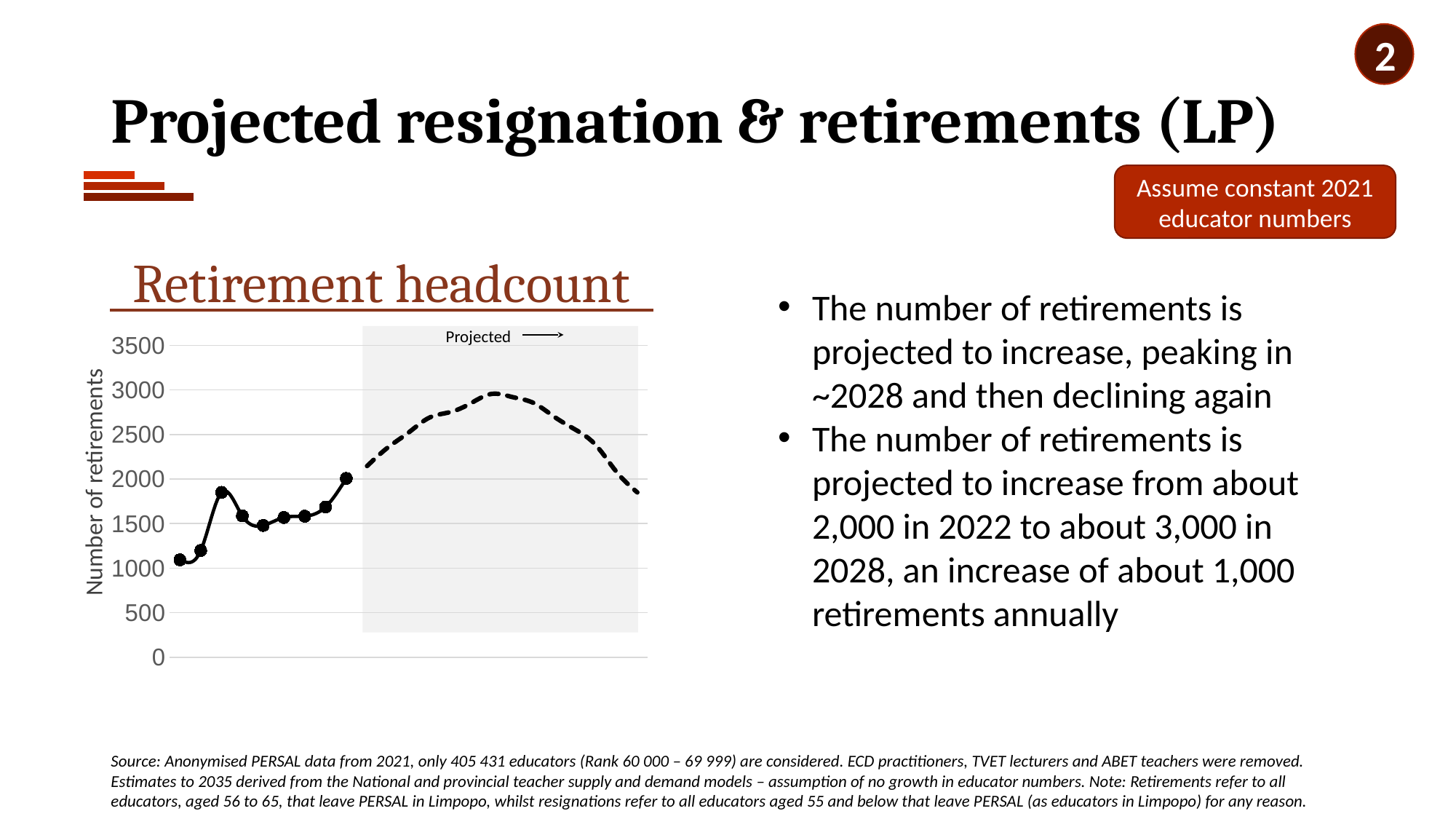
What is the highest value shown on the vertical axis? 3500 Which marked point on the solid line has the highest value? the last (ninth) point What kind of chart is shown on the slide? line chart What is the label on the vertical axis of the chart? Number of retirements Is the value of the third marked point on the line greater or less than 1500? greater Is the value of the first marked point on the line greater or less than 1500? less Is the value of the last marked point on the solid line larger or smaller than the value of the first marked point? larger How many marked data points are on the solid (actual) part of the line? 9 What is the title of the chart? Retirement headcount Does the dashed projected line rise or fall after reaching its peak? fall Is the final value at the right end of the dashed projected line greater or less than 2500? less